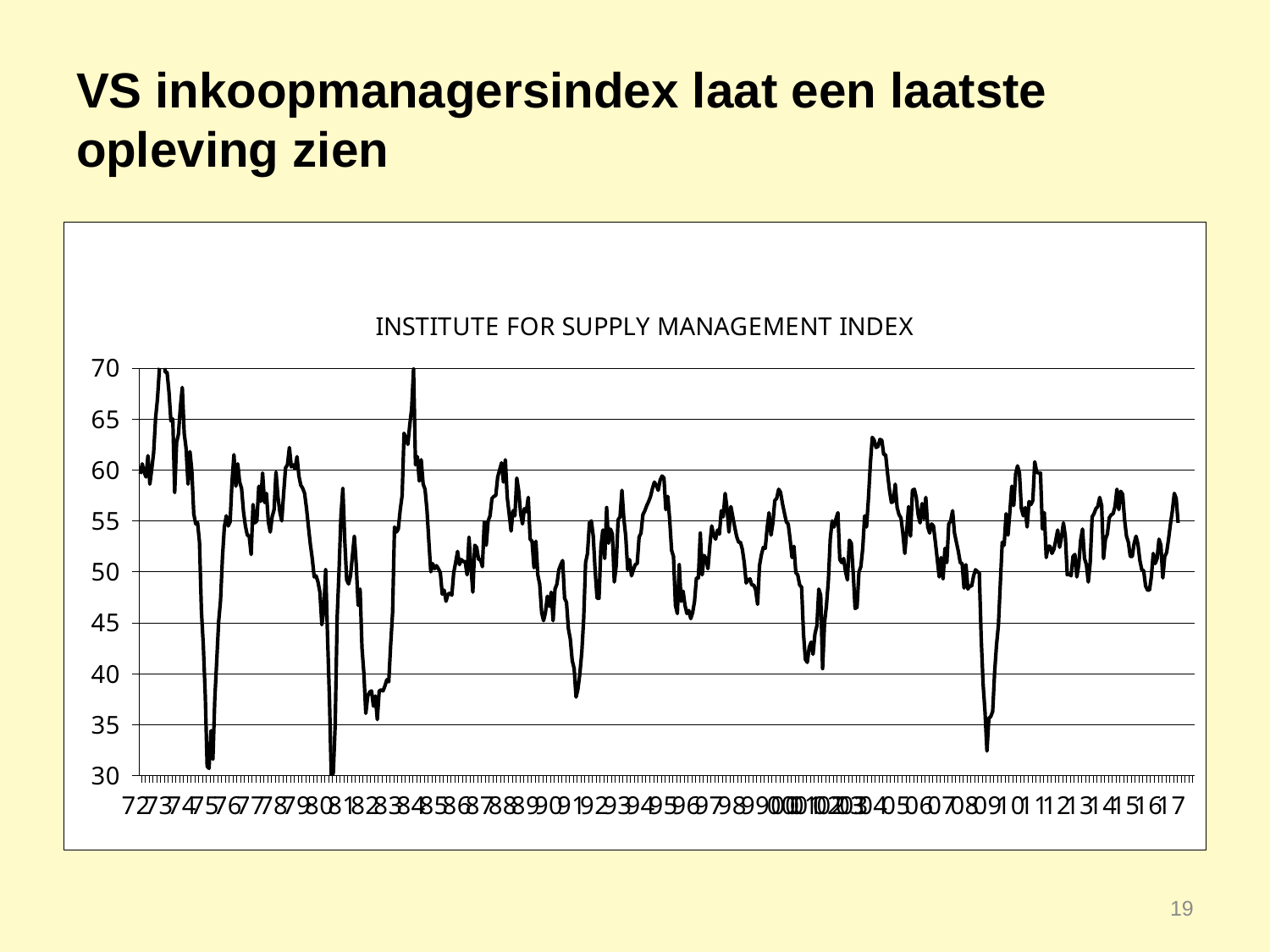
What is the highest value shown on the vertical axis? 70 What is the lowest value shown on the vertical axis? 30 What kind of chart is shown on the slide? line chart Is the lowest point of the line greater or less than 35? less What is the title of the chart? INSTITUTE FOR SUPPLY MANAGEMENT INDEX Is the highest point of the line greater or less than 65? greater How many lines (series) are plotted on the chart? 1